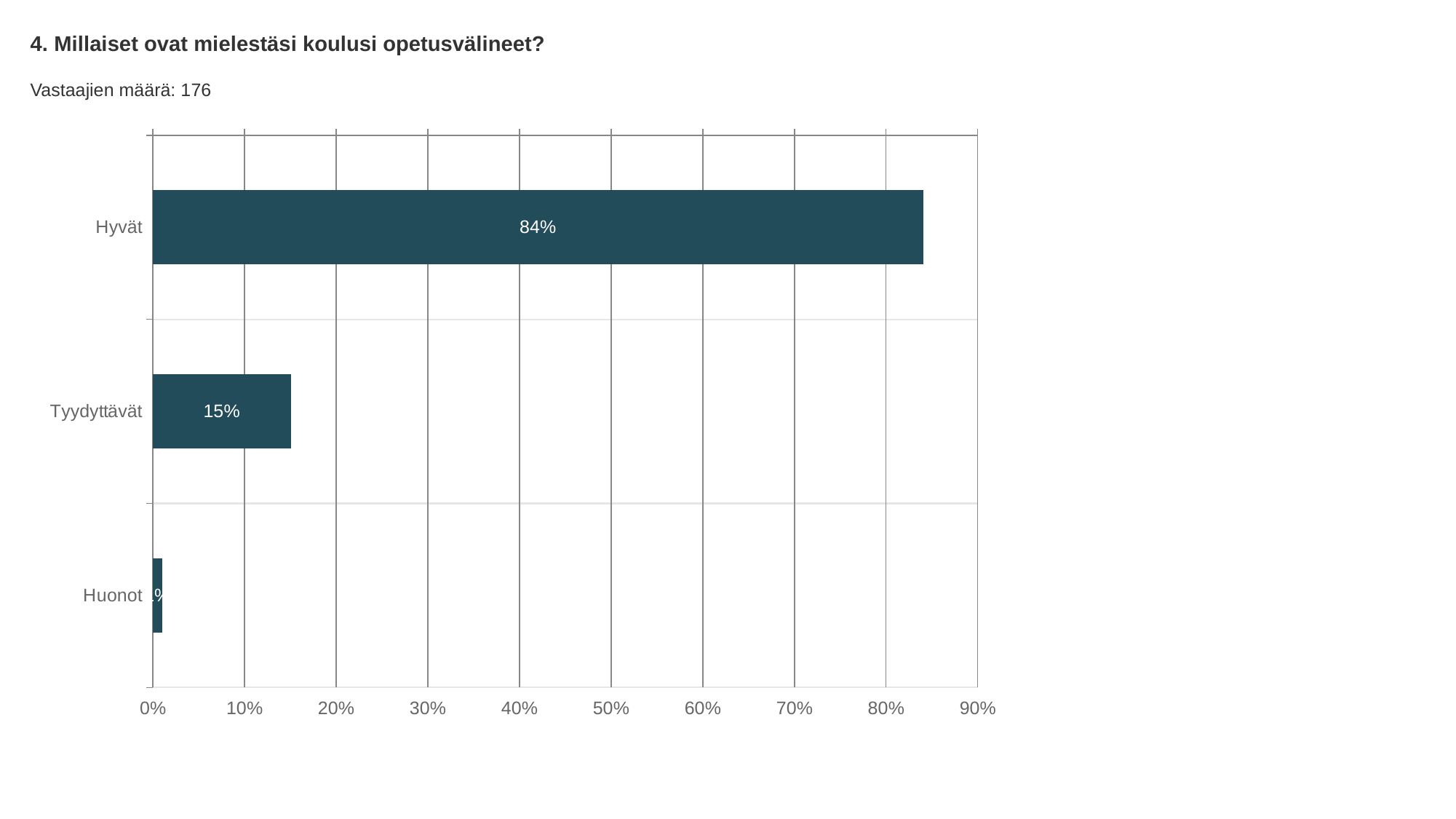
What kind of chart is shown on the slide? bar chart How many respondents (Vastaajien määrä) does the slide report? 176 What is the value for Hyvät? 84% Which is larger, the value for Tyydyttävät or the value for Huonot? Tyydyttävät What is the difference between the values for Hyvät and Tyydyttävät? 69% Which category has the highest value? Hyvät Which category has the lowest value? Huonot What is the title of the chart? 4. Millaiset ovat mielestäsi koulusi opetusvälineet? How many categories are shown in the chart? 3 Is the value for Huonot greater or less than 10%? less Is the value for Hyvät greater or less than 80%? greater What is the value for Tyydyttävät? 15%